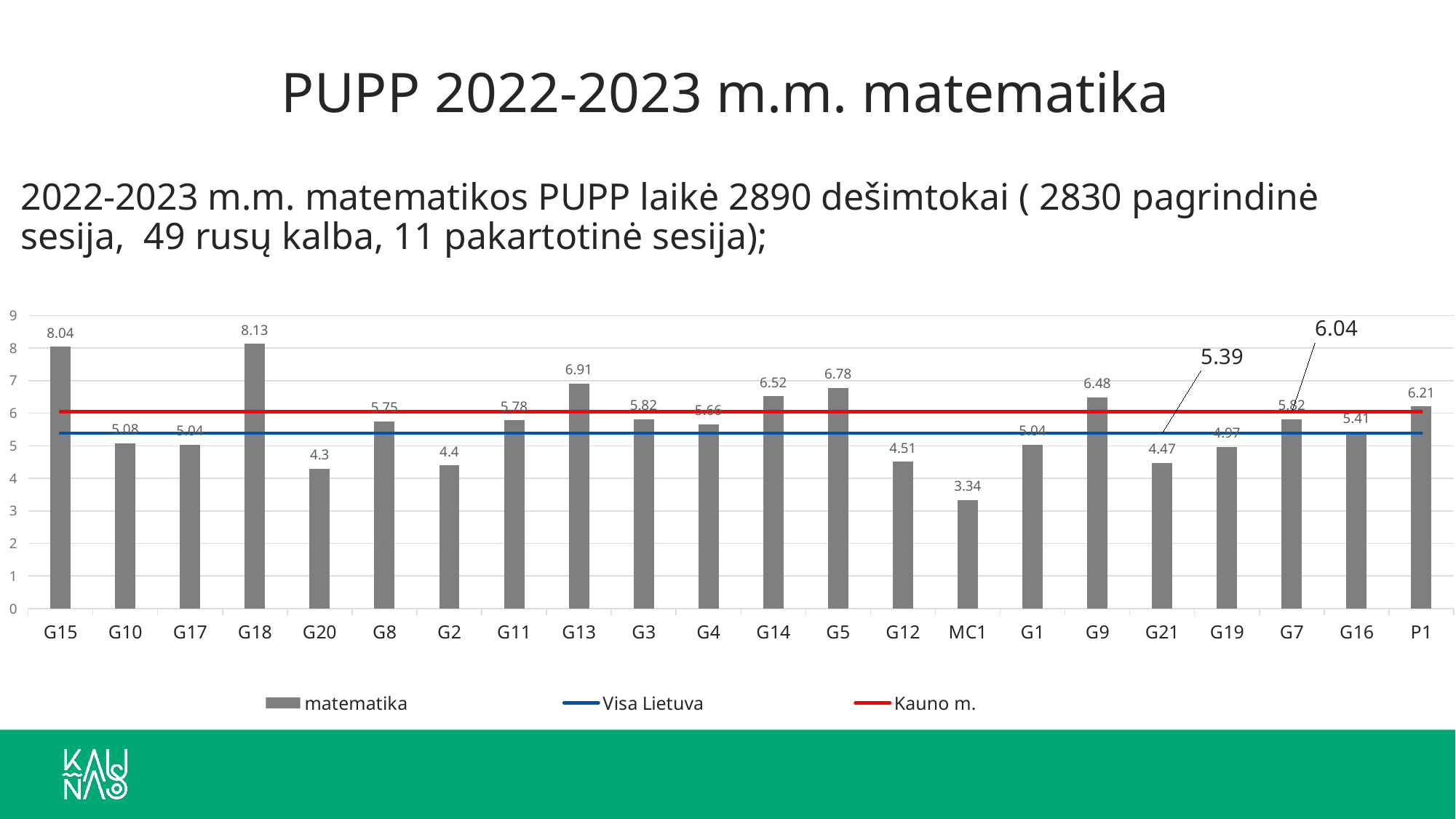
How many categories are shown on the x axis? 22 Which has a higher matematika value, G5 or G14? G5 What kind of chart is used to show the matematika values? Bar chart Which category has the lowest matematika value? MC1 What is the matematika value for MC1? 3.34 What is the difference between the matematika values for G18 and G15? 0.09 Which category has the highest matematika value? G18 What value is labelled for the Visa Lietuva line? 5.39 What is the matematika value for G18? 8.13 What is the matematika value for G13? 6.91 What value is labelled for the Kauno m. line? 6.04 How many series does the legend list? 3